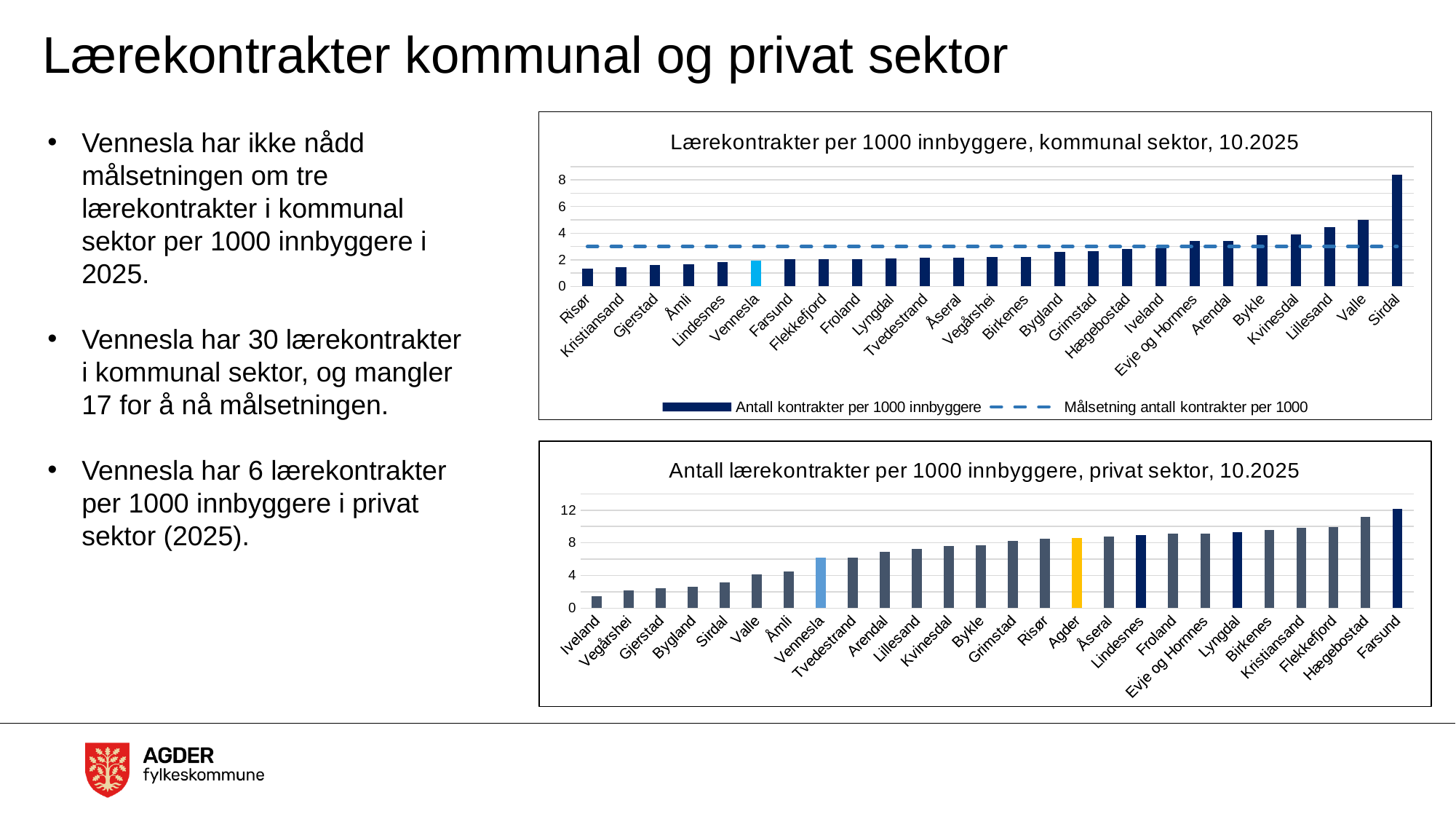
In the bottom chart (privat sektor), which municipality has the highest value? Farsund In the top chart (kommunal sektor), what value does the dashed target line (Målsetning) sit at? 3 In the bottom chart (privat sektor), which municipality has the lowest value? Iveland In the top chart (kommunal sektor), how many series does the legend list? 2 What kind of chart is the bottom chart (privat sektor)? bar chart In the bottom chart (privat sektor), which is larger, the value for Vennesla or the value for Agder? Agder In the top chart (kommunal sektor), is the value for Vennesla greater or less than 3? less In the top chart (kommunal sektor), which municipality has the highest number of lærekontrakter per 1000 innbyggere? Sirdal In the top chart (kommunal sektor), which municipality has the lowest value? Risør In the bottom chart (privat sektor), do the values rise or fall from left to right along the x axis? rise In the top chart (kommunal sektor), is the value for Sirdal greater or less than 6? greater